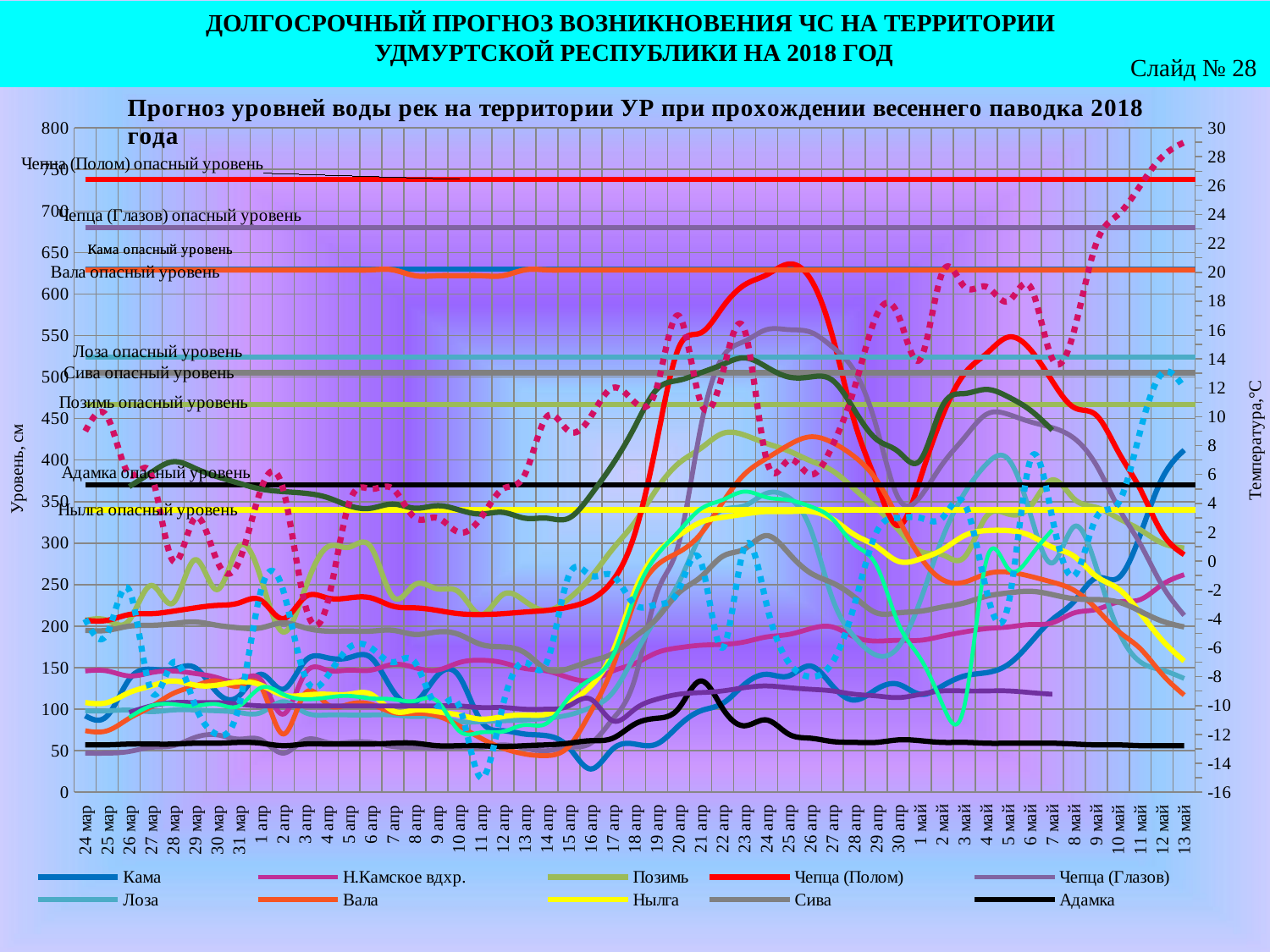
What is the highest value shown on the left vertical axis? 800 Is the value for Кама on 13 май greater or less than 350? greater Is the value for Нылга on 13 май greater or less than 200? less On 25 апр, which is higher: Чепца (Полом) or Адамка? Чепца (Полом) Does the Чепца (Полом) series rise or fall from 25 апр to 13 май? fall What kind of chart is shown on the slide? line chart What is the title of the left vertical axis? Уровень, см How many series does the chart legend list? 10 Which series reaches the highest water level on the chart? Чепца (Полом) Is the value for Адамка on 13 май greater or less than 100? less What is the title of the right vertical axis? Температура,°C